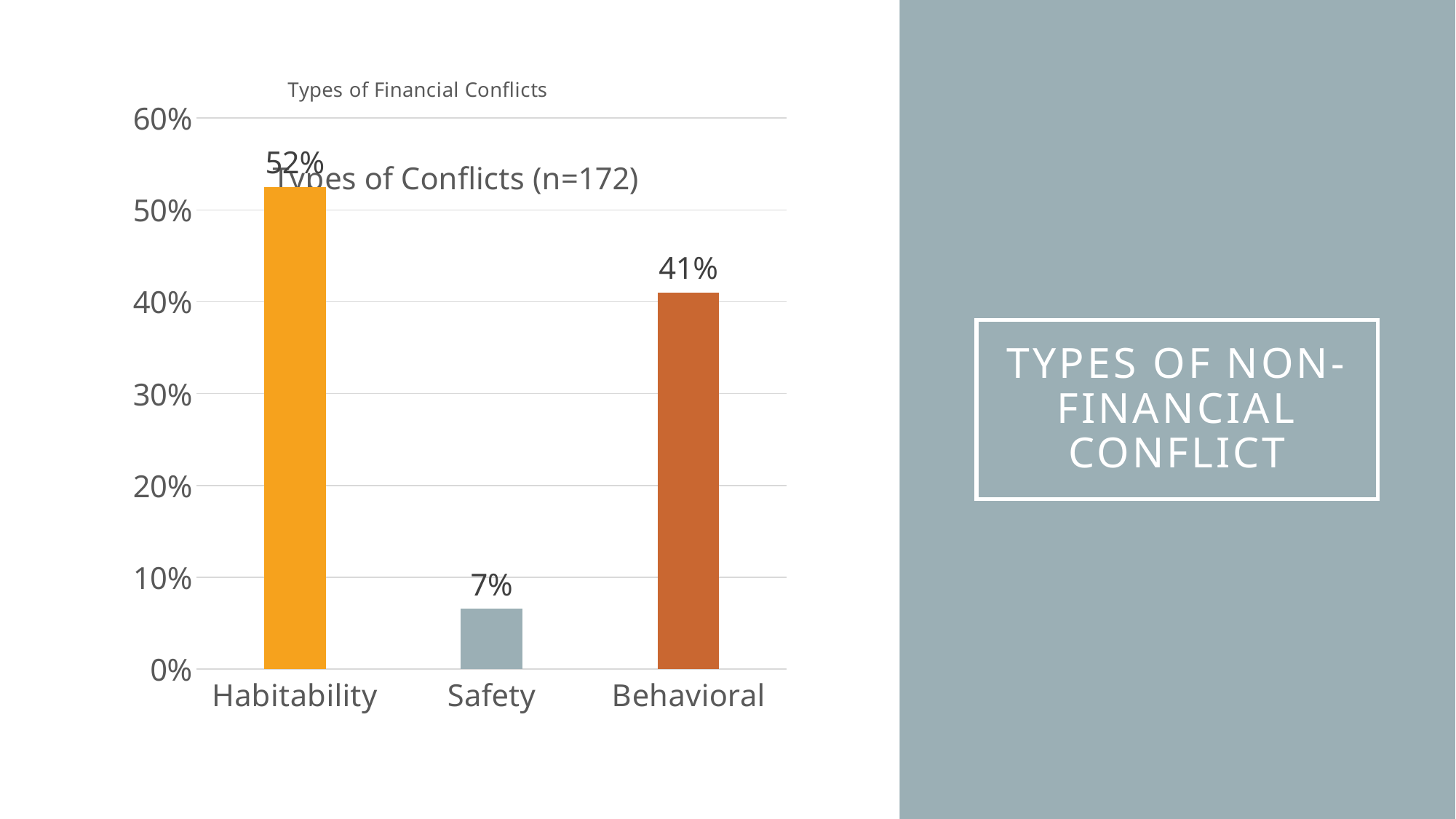
Which category has the lowest value? Safety Is the value for Behavioral greater or less than 50%? less What is the difference between the values for Habitability and Behavioral? 11% What is the value for Behavioral? 41% How many categories are shown on the x axis? 3 What is the value for Habitability? 52% Which is larger, the value for Safety or the value for Behavioral? Behavioral What is the difference between the values for Behavioral and Safety? 34% What is the sample size shown in the chart title? n=172 What kind of chart is shown on the slide? bar chart What is the value for Safety? 7% Which category has the highest value? Habitability